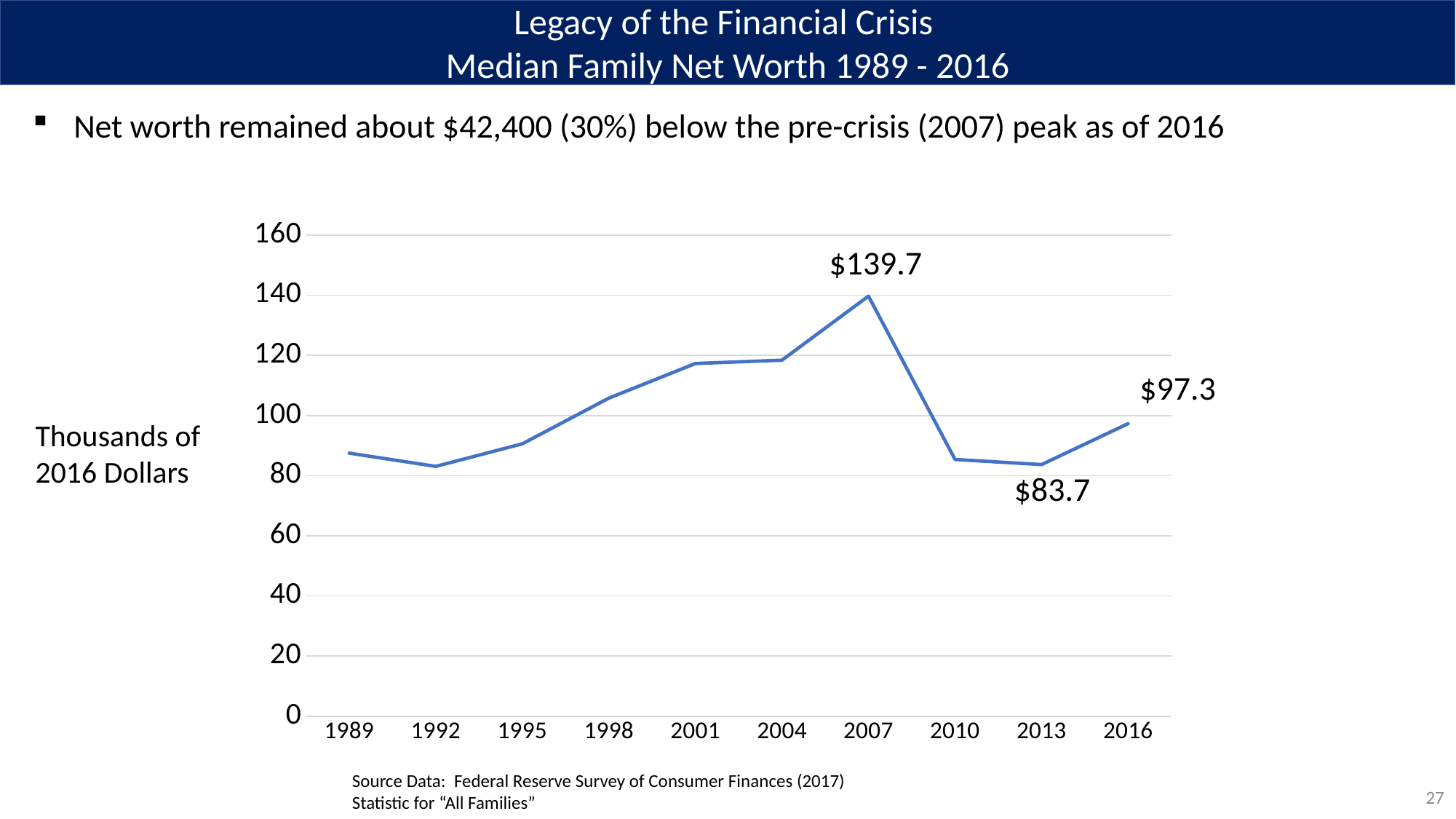
What value is labelled for 2013? $83.7 What is the median family net worth shown for 2007? $139.7 Is the value for 2001 greater or less than 100? greater Does the value rise or fall from 2007 to 2010? fall What is the difference between the 2007 value and the 2016 value? $42.4 By how much did the value rise from 2013 to 2016? $13.6 How many years are plotted on the x axis? 10 Which year has the larger value, 2007 or 2016? 2007 What value is labelled for 2016? $97.3 What kind of chart is shown? line chart In which year is median family net worth highest? 2007 Is the value for 1989 greater or less than 100? less